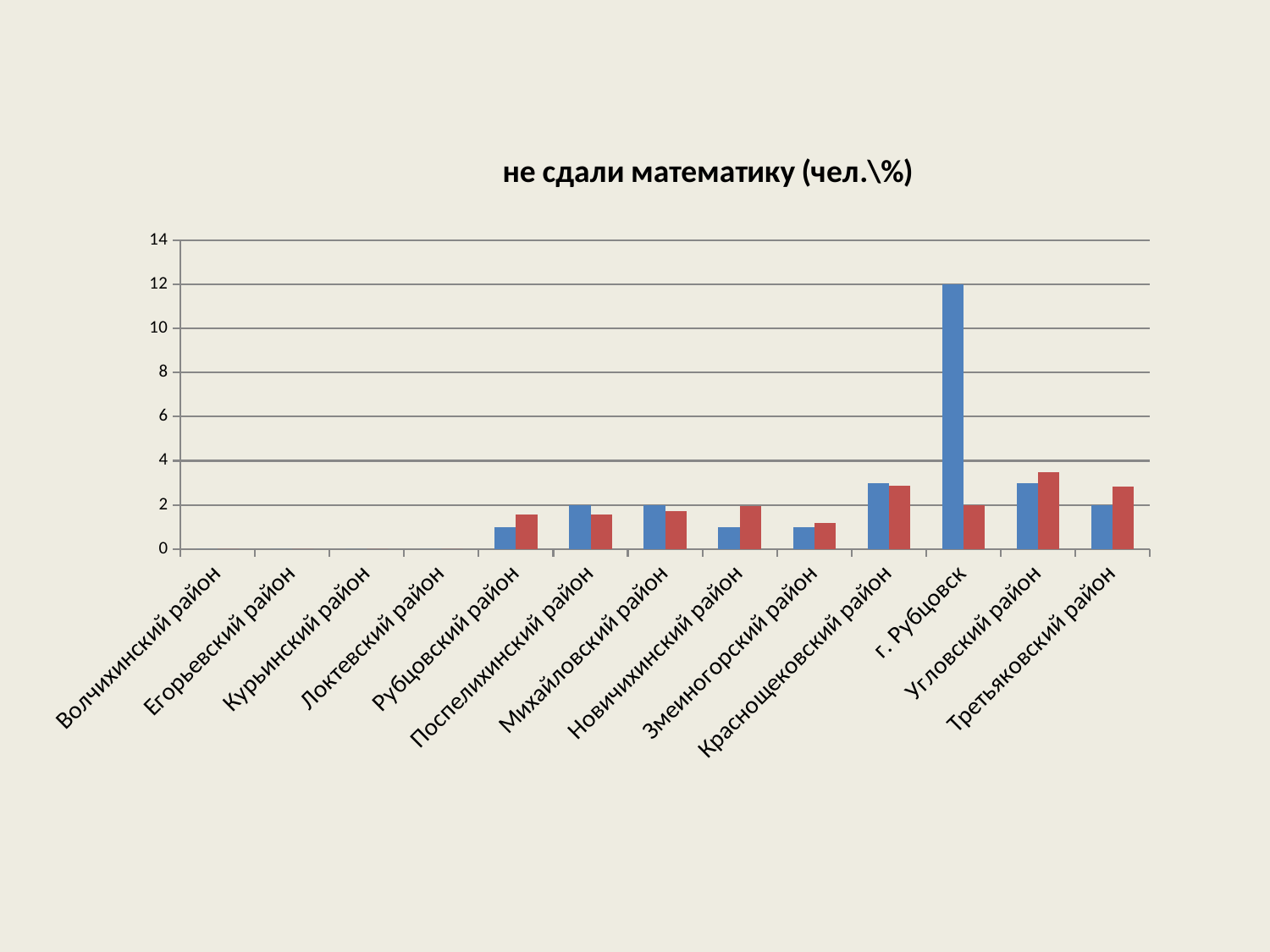
How many categories (districts) are shown on the x axis? 13 Is the value of the blue bar for г. Рубцовск greater or less than 10? greater For Угловский район, which bar is taller, the blue one or the red one? red How many categories have no visible bars at all? 4 What is the value of the blue bar for Поспелихинский район? 2 What is the title of the chart? не сдали математику (чел.\%) Is the value of the red bar for Угловский район greater or less than 2? greater What is the value of the blue bar for г. Рубцовск? 12 What kind of chart is shown on the slide? bar chart Which category has the tallest blue bar? г. Рубцовск